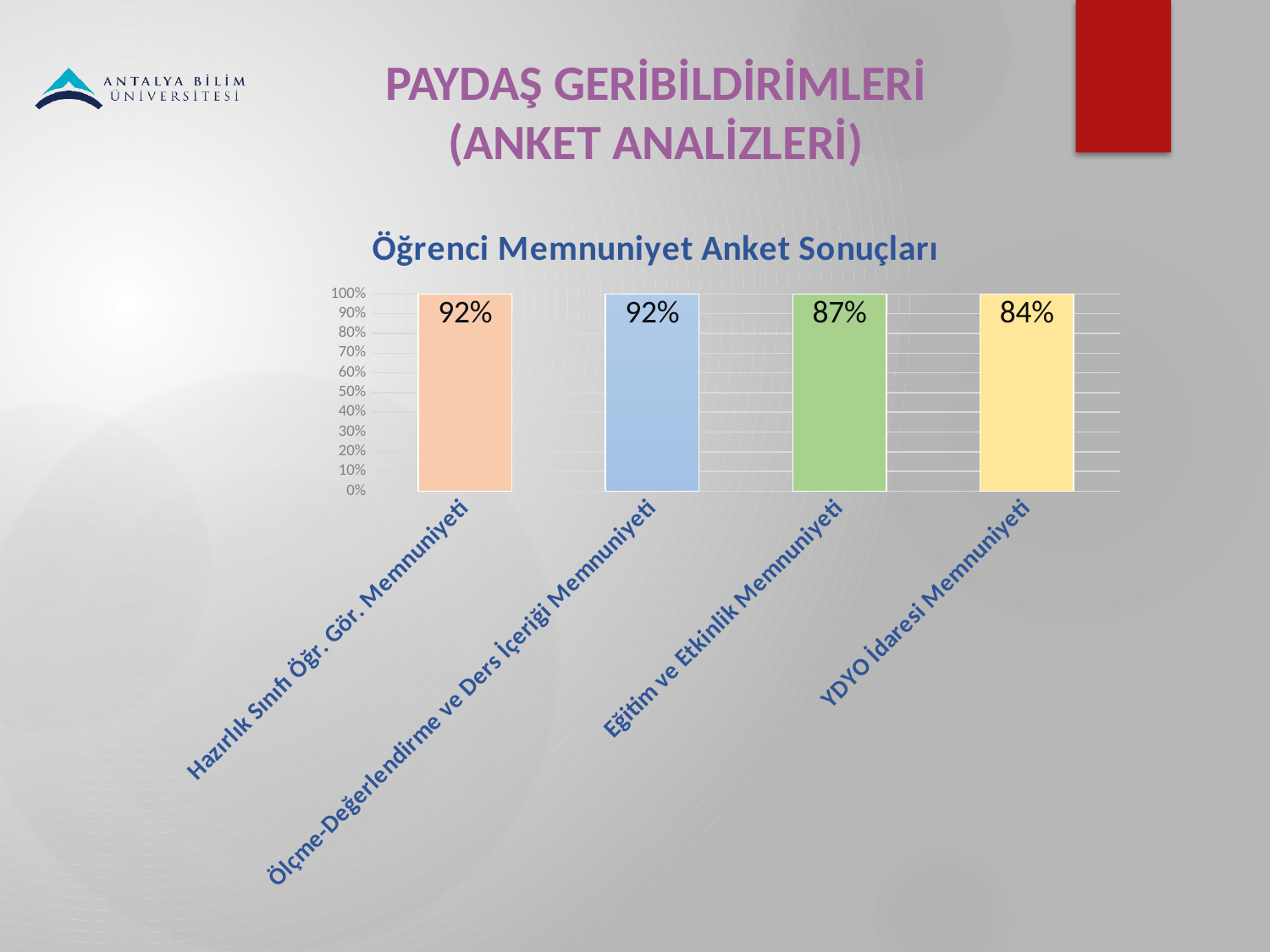
What is the difference between Hazırlık Sınıfı Öğr. Gör. Memnuniyeti and YDYO İdaresi Memnuniyeti? 8% Which category has the lowest value? YDYO İdaresi Memnuniyeti What is the value for Ölçme-Değerlendirme ve Ders İçeriği Memnuniyeti? 92% What is the value for Eğitim ve Etkinlik Memnuniyeti? 87% What is the difference between Ölçme-Değerlendirme ve Ders İçeriği Memnuniyeti and Eğitim ve Etkinlik Memnuniyeti? 5% How many categories are shown in the chart? 4 What is the value for Hazırlık Sınıfı Öğr. Gör. Memnuniyeti? 92% What is the title of the chart? Öğrenci Memnuniyet Anket Sonuçları What kind of chart is shown on the slide? Bar chart Which is larger: Eğitim ve Etkinlik Memnuniyeti or YDYO İdaresi Memnuniyeti? Eğitim ve Etkinlik Memnuniyeti What is the value for YDYO İdaresi Memnuniyeti? 84% Do the labelled values generally rise or fall from left to right across the categories? Fall